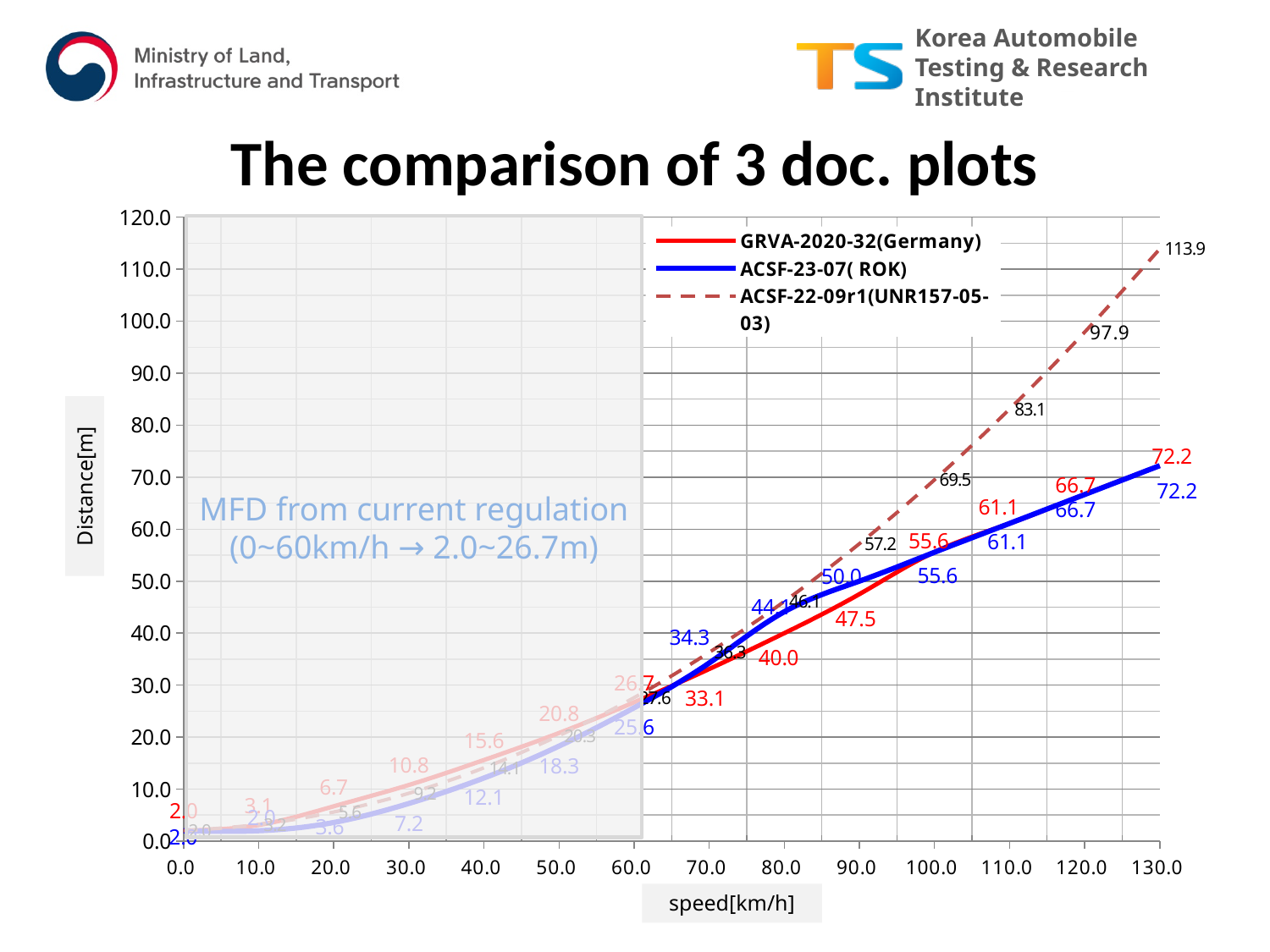
At 90 km/h, which is larger: the ACSF-22-09r1(UNR157-05-03) value or the GRVA-2020-32(Germany) value? ACSF-22-09r1(UNR157-05-03) What is the distance value for the ACSF-23-07( ROK) series at 70 km/h? 34.3 Do the distance values rise or fall as speed increases along the x axis? rise What is the distance value for the GRVA-2020-32(Germany) series at 90 km/h? 47.5 What is the distance value for the ACSF-22-09r1(UNR157-05-03) series at 130 km/h? 113.9 What is the label of the x axis? speed[km/h] Which series reaches the highest distance value at 130 km/h? ACSF-22-09r1(UNR157-05-03) How many series does the legend list? 3 What is the distance value for the ACSF-22-09r1(UNR157-05-03) series at 110 km/h? 83.1 What kind of chart is shown on the slide? line chart What is the difference between the ACSF-22-09r1(UNR157-05-03) value and the GRVA-2020-32(Germany) value at 130 km/h? 41.7 Is the value for the GRVA-2020-32(Germany) series at 90 km/h greater or less than 50? less